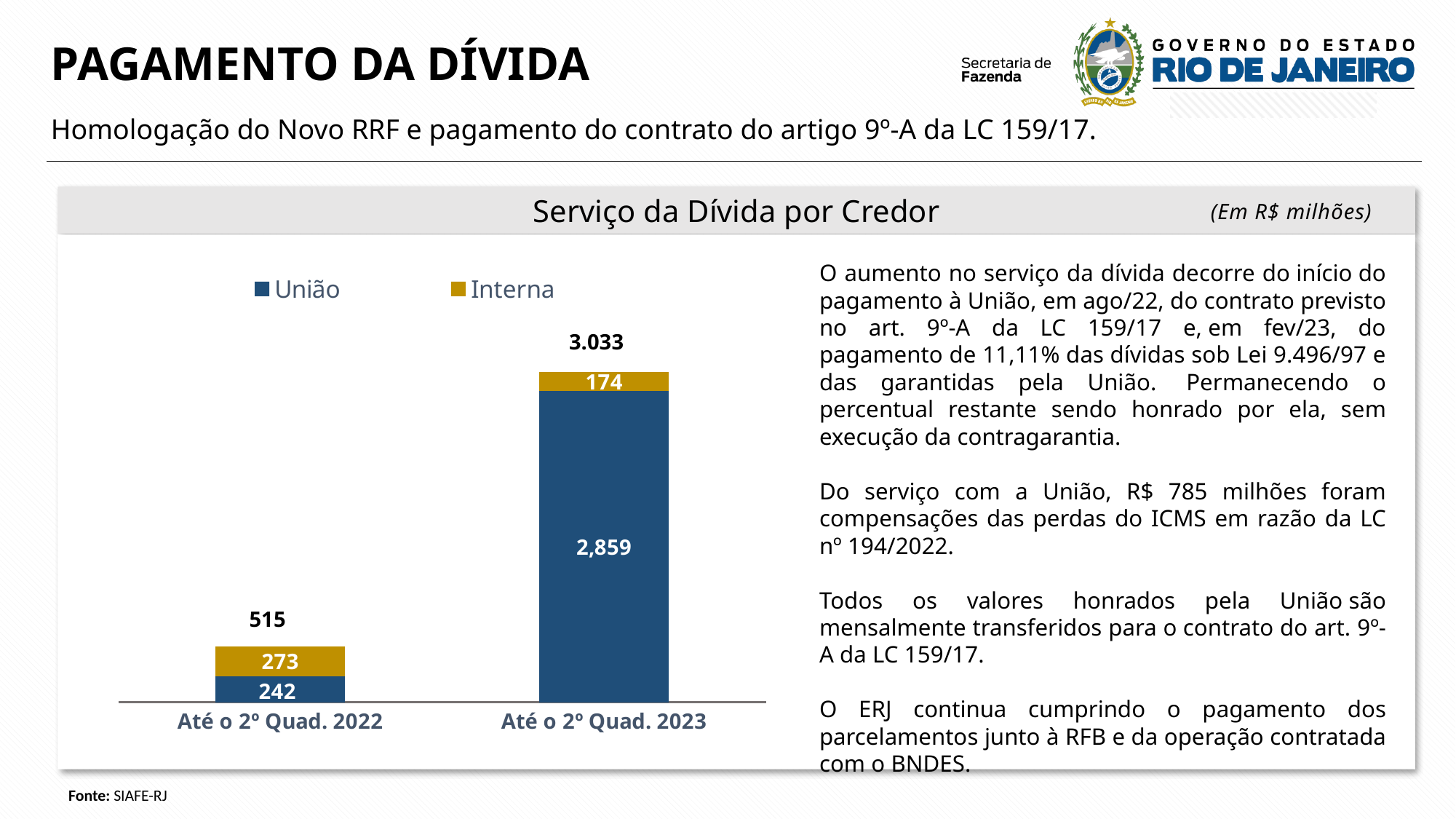
What kind of chart is shown? Stacked bar chart What is the title of the chart? Serviço da Dívida por Credor Which category has the higher total, 'Até o 2º Quad. 2022' or 'Até o 2º Quad. 2023'? Até o 2º Quad. 2023 How many series does the legend list? 2 What is the value for Interna in the 'Até o 2º Quad. 2023' bar? 174 What is the value for União in the 'Até o 2º Quad. 2023' bar? 2,859 What is the total shown above the 'Até o 2º Quad. 2023' bar? 3.033 What is the value for União in the 'Até o 2º Quad. 2022' bar? 242 What is the value for Interna in the 'Até o 2º Quad. 2022' bar? 273 How many categories are shown on the x axis? 2 What is the total shown above the 'Até o 2º Quad. 2022' bar? 515 What is the difference between the Interna values for 'Até o 2º Quad. 2022' and 'Até o 2º Quad. 2023'? 99